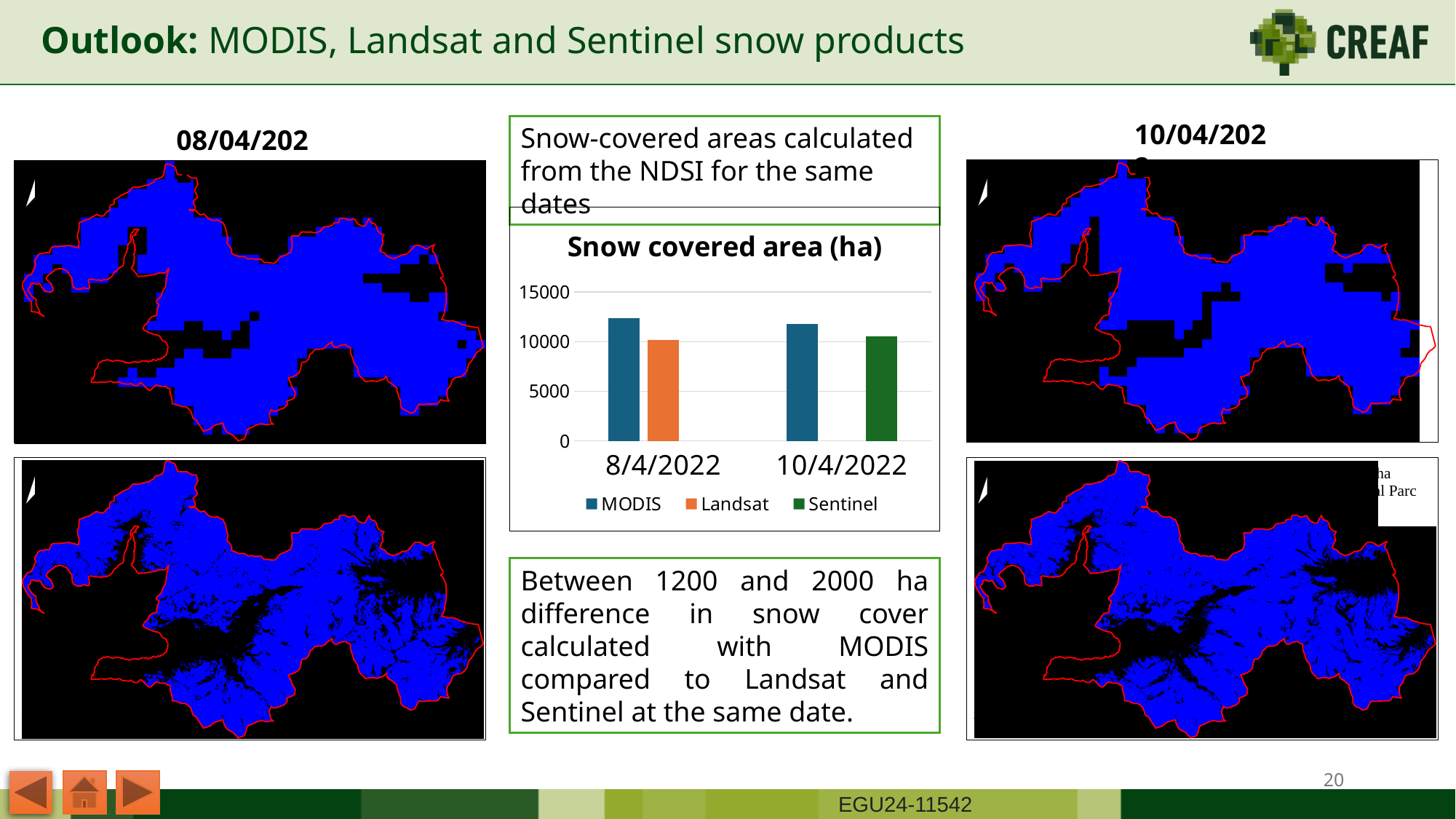
In the "Snow covered area (ha)" chart, is the Landsat value for 8/4/2022 greater or less than 15000? less In the "Snow covered area (ha)" chart, which is larger on 8/4/2022: MODIS or Landsat? MODIS Which series is shown in orange in the "Snow covered area (ha)" chart? Landsat In the "Snow covered area (ha)" chart, is the MODIS value for 10/4/2022 greater or less than 15000? less How many series does the legend of the "Snow covered area (ha)" chart list? 3 What is the title of the chart on the slide? Snow covered area (ha) How many dates (categories) are shown on the x axis of the "Snow covered area (ha)" chart? 2 In the "Snow covered area (ha)" chart, is the MODIS value for 8/4/2022 greater or less than 10000? greater Which series appears on both dates in the "Snow covered area (ha)" chart? MODIS What kind of chart is the "Snow covered area (ha)" chart? bar chart In the "Snow covered area (ha)" chart, which is larger on 10/4/2022: MODIS or Sentinel? MODIS